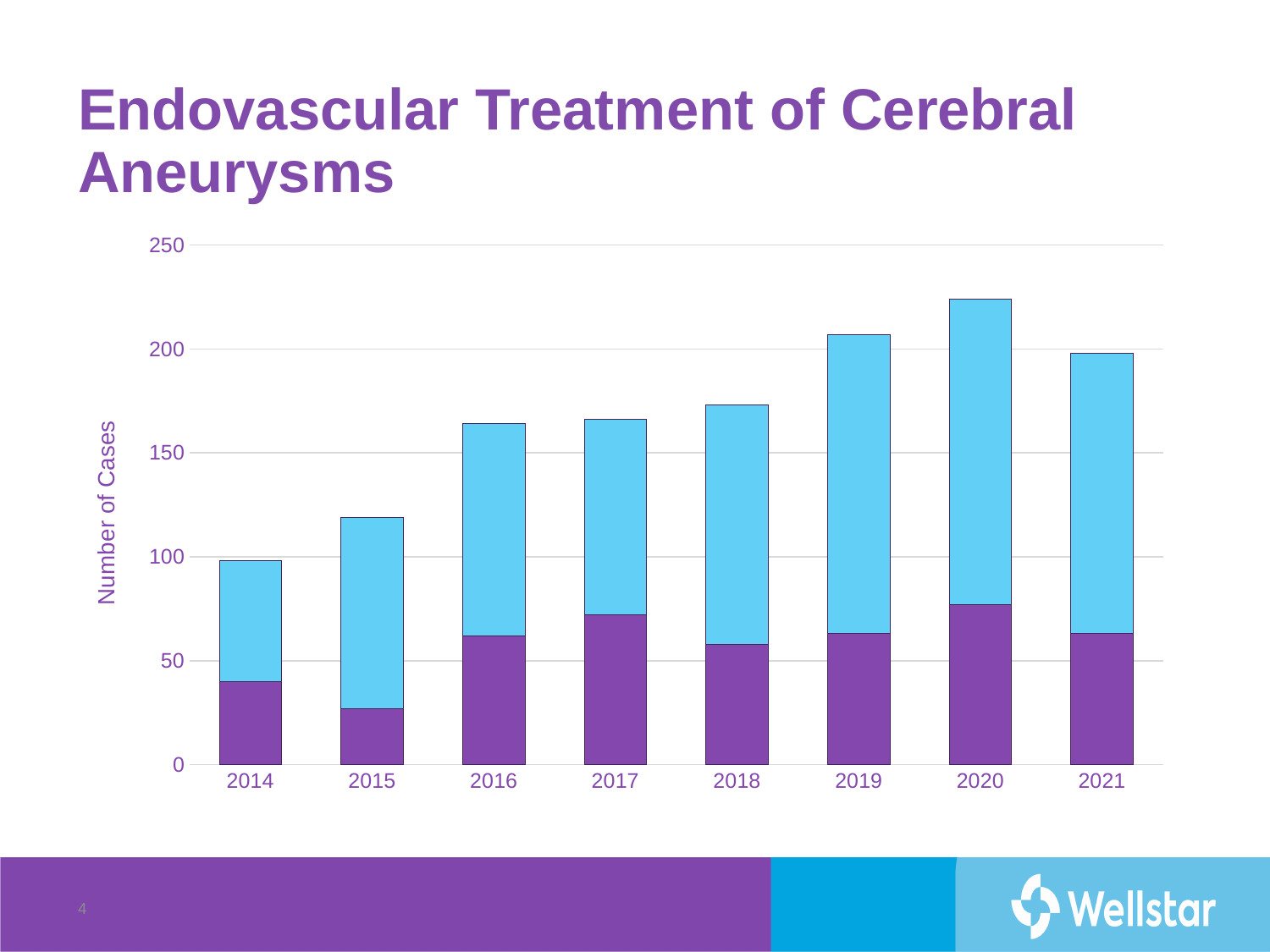
Is the total number of cases for 2020 greater or less than 200? greater Is the total number of cases for 2015 greater or less than 100? greater What kind of chart is shown on the slide? Stacked bar chart Which year has the shortest bar (lowest total number of cases)? 2014 What is the label on the y axis of the chart? Number of Cases How many years are shown along the x axis of the chart? 8 Is the purple (bottom) segment for 2015 greater or less than 50? less Which year has the larger total number of cases, 2019 or 2020? 2020 Do the bar totals generally rise or fall from 2014 to 2020? rise Which year has the tallest bar (highest total number of cases)? 2020